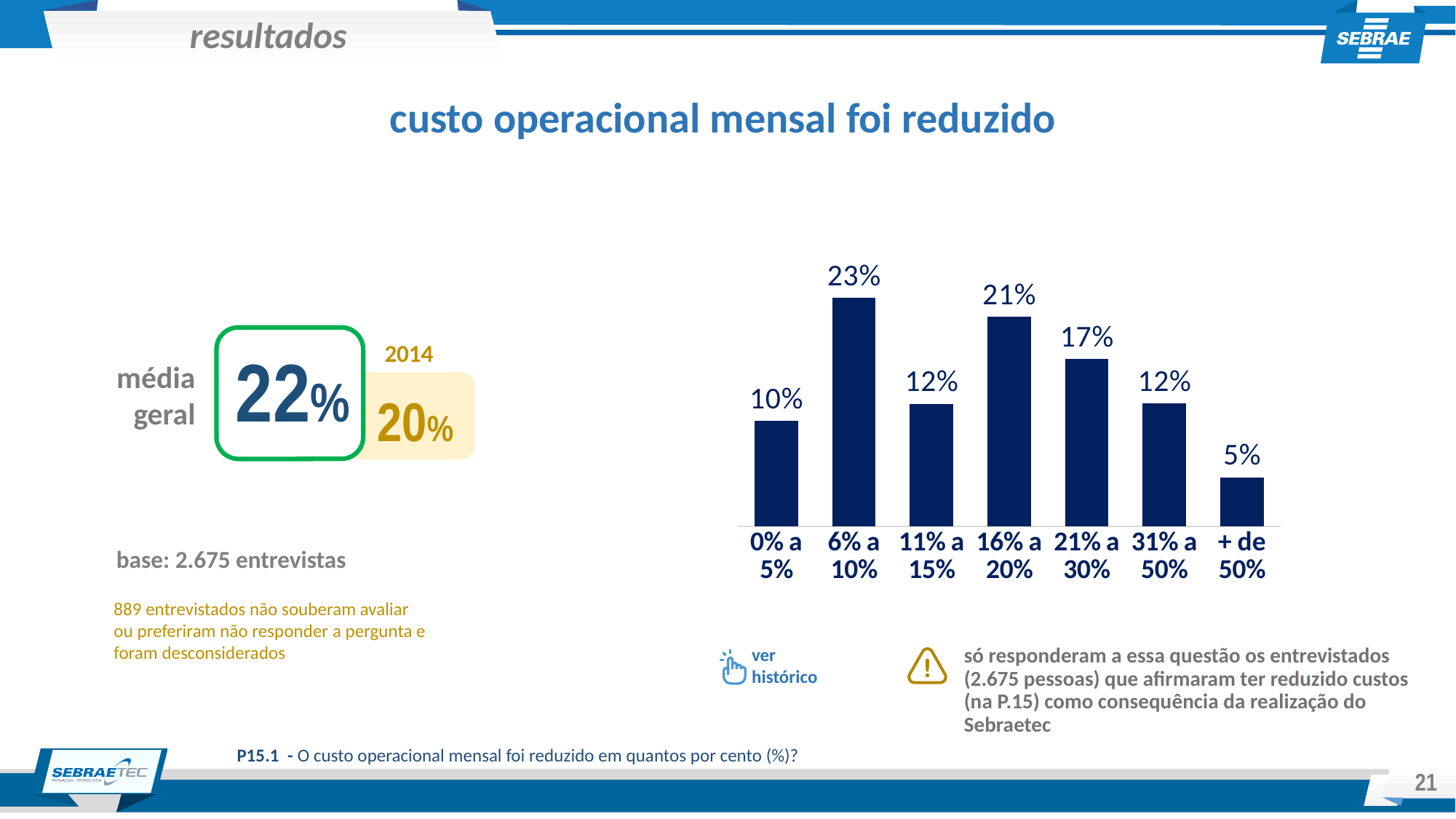
Which is larger, the value for '16% a 20%' or the value for '21% a 30%'? 16% a 20% How many categories are shown on the x axis of the bar chart? 7 What percentage of respondents reported a monthly operating cost reduction of 6% a 10%? 23% Which category has the lowest value in the bar chart? + de 50% What is the 'média geral' value shown in the green box on the slide? 22% What kind of chart is shown on the slide? Bar chart What is the difference between the values for '6% a 10%' and '16% a 20%'? 2% What is the value shown for the '21% a 30%' category? 17% Which category has the highest value in the bar chart? 6% a 10% Which two categories share the same value of 12%? 11% a 15% and 31% a 50% What is the difference between the values for '0% a 5%' and '+ de 50%'? 5% What is the value shown for the '+ de 50%' category? 5%